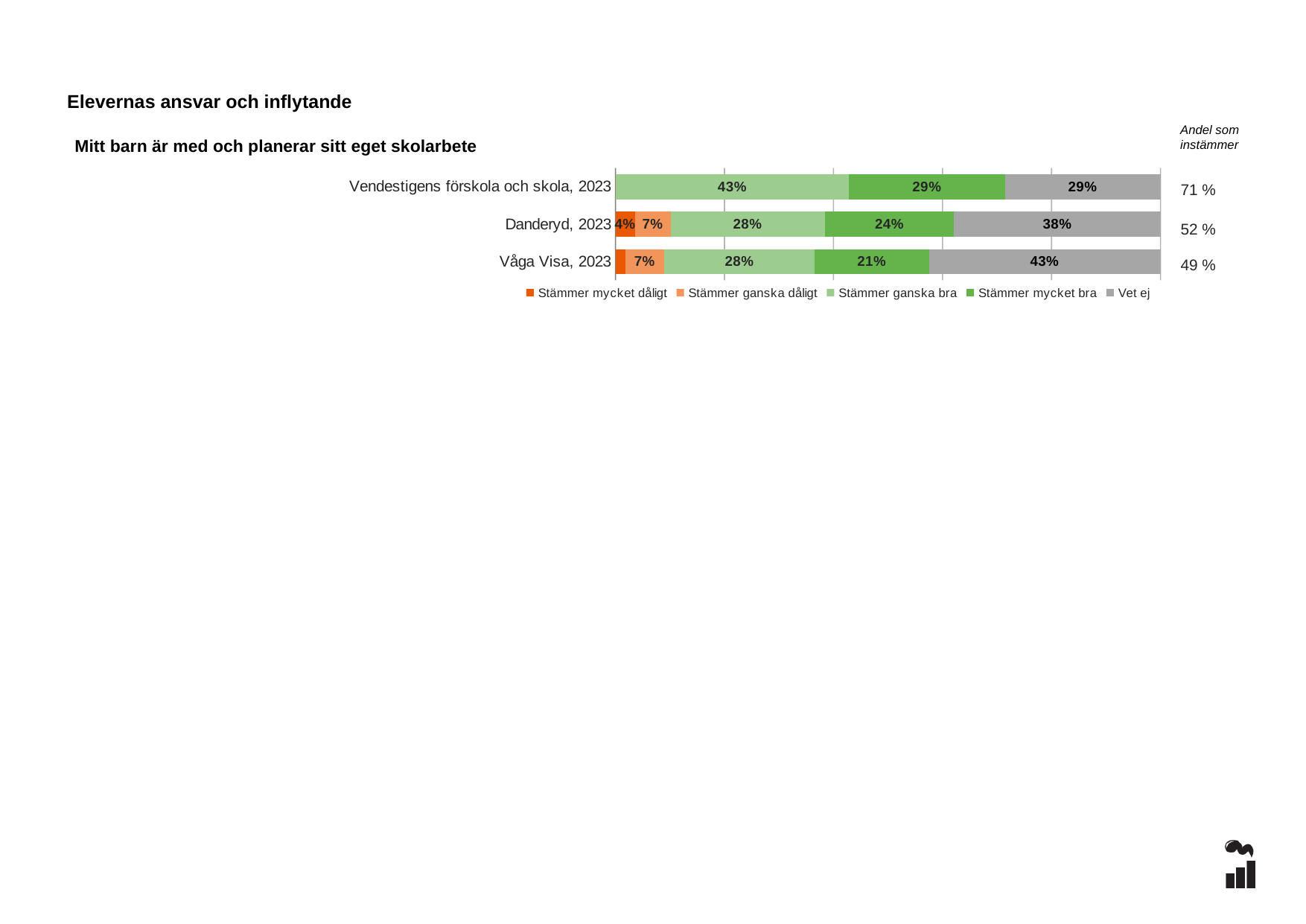
What kind of chart is shown on the slide? Stacked bar chart How many categories (rows) are plotted in the chart? 3 Which category has the highest 'Vet ej' value? Våga Visa, 2023 What is the 'Andel som instämmer' value shown for Danderyd, 2023? 52 % What is the value of 'Stämmer mycket dåligt' for Danderyd, 2023? 4% Which is larger: 'Stämmer mycket bra' for Danderyd, 2023 or for Vendestigens förskola och skola, 2023? Vendestigens förskola och skola, 2023 What is the value of 'Stämmer ganska bra' for Vendestigens förskola och skola, 2023? 43% What is the value of 'Stämmer mycket bra' for Våga Visa, 2023? 21% What is the value of 'Vet ej' for Danderyd, 2023? 38% Which category has the lowest 'Stämmer mycket bra' value? Våga Visa, 2023 What is the difference between the 'Stämmer ganska bra' values for Vendestigens förskola och skola, 2023 and Danderyd, 2023? 15% How many series does the legend list? 5